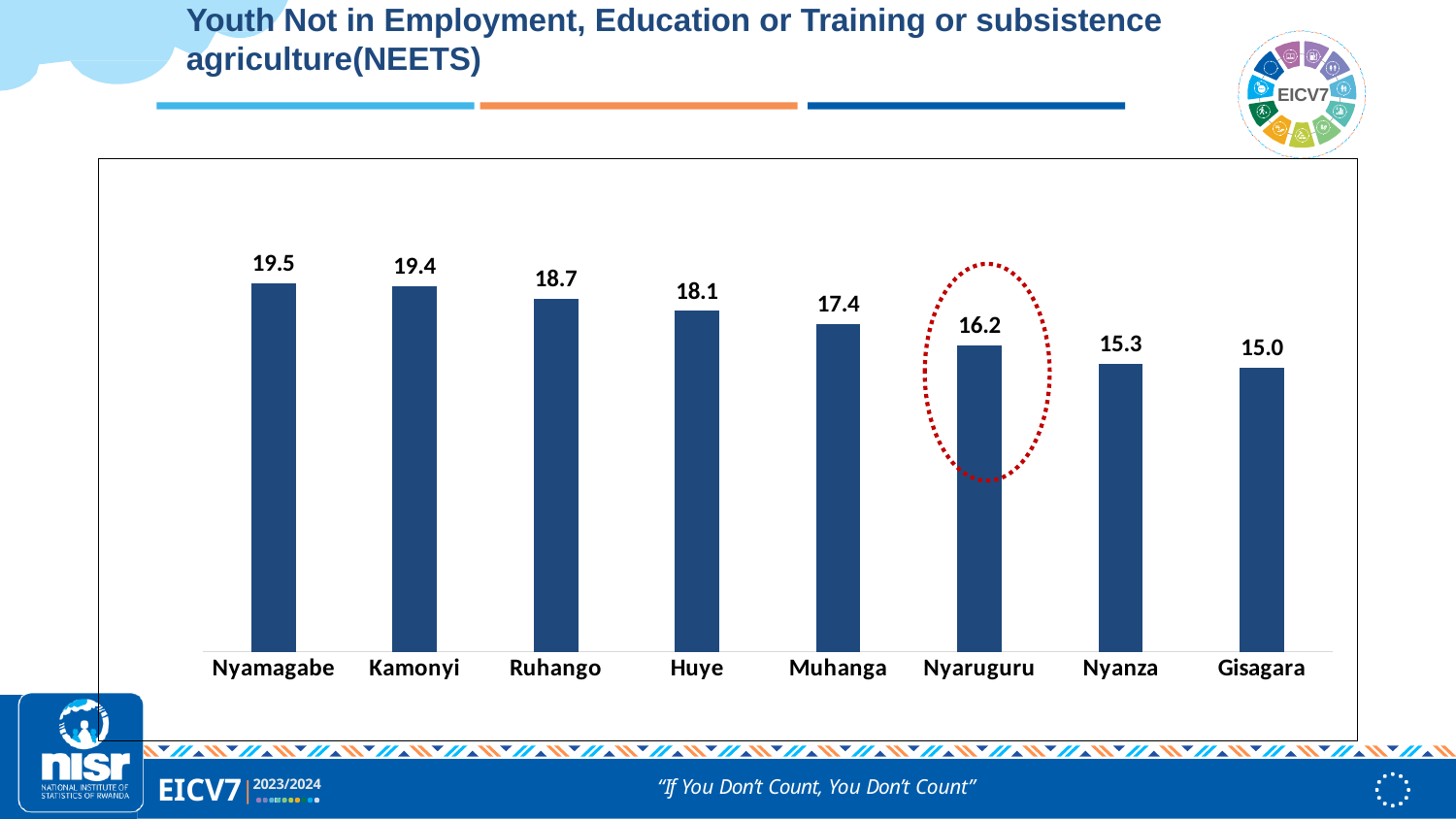
What is the difference between the values for Huye and Nyanza? 2.8 Which district has the highest value? Nyamagabe Which is larger, the value for Ruhango or the value for Muhanga? Ruhango How many districts are shown in the chart? 8 What kind of chart is shown on the slide? bar chart Which district's bar is circled with a red dotted outline? Nyaruguru What is the value for Nyaruguru? 16.2 Which district has the lowest value? Gisagara Do the values rise or fall from left to right across the districts? fall What is the value for Muhanga? 17.4 What is the value for Nyamagabe? 19.5 What is the difference between the values for Nyamagabe and Gisagara? 4.5